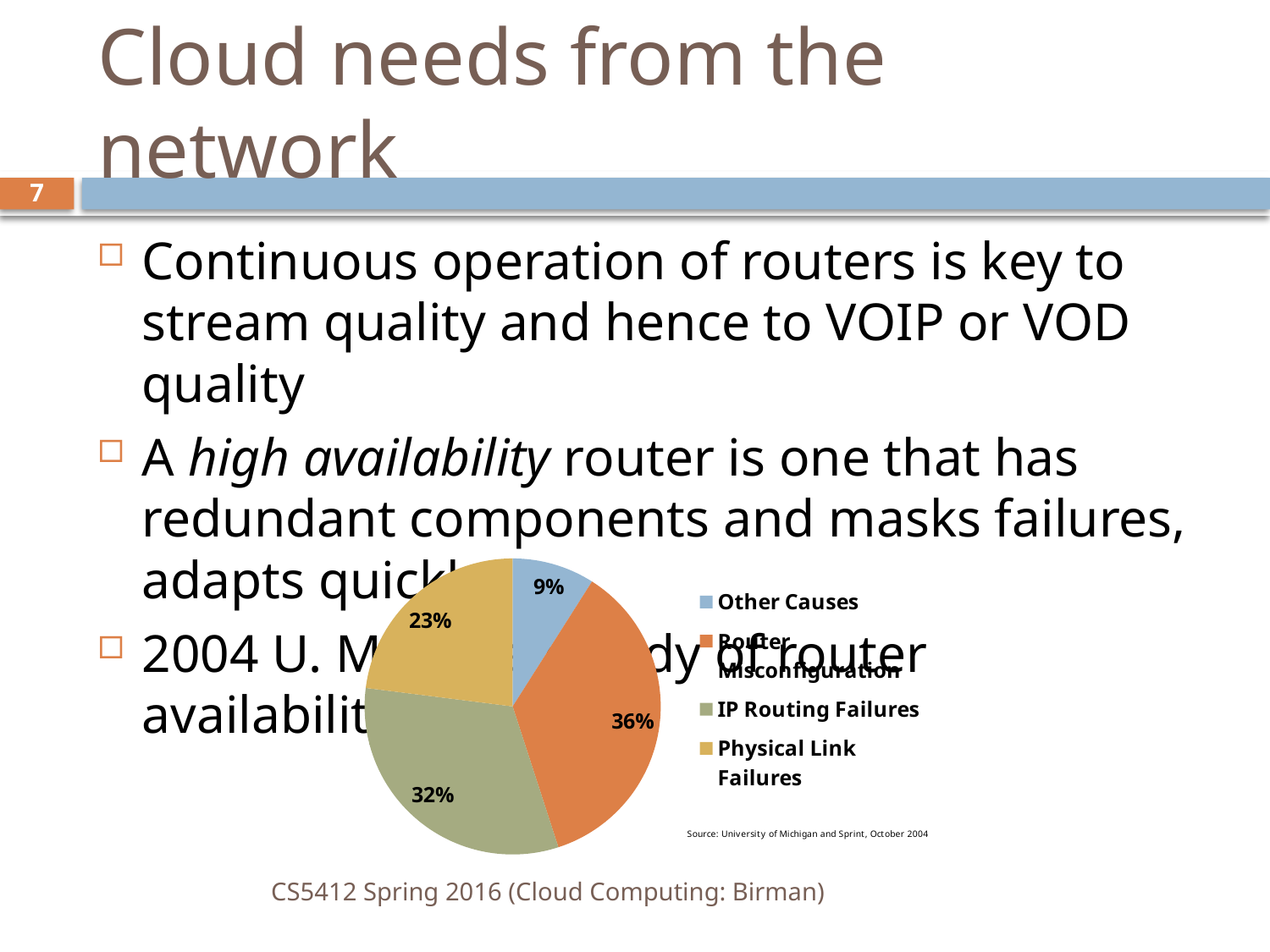
What percentage of the pie is attributed to Other Causes? 9% What percentage of the pie is attributed to Router Misconfiguration? 36% What colour is the slice for Physical Link Failures? yellow What is the difference in percentage points between Router Misconfiguration and Physical Link Failures? 13 Which category has the smallest share of the pie? Other Causes Which category has the largest share of the pie? Router Misconfiguration According to the source note under the chart, which organisations provided the data? University of Michigan and Sprint How many slices does the pie chart have? 4 What percentage of the pie is attributed to IP Routing Failures? 32% What type of chart is shown on the slide? pie chart Which is larger, the share for IP Routing Failures or the share for Physical Link Failures? IP Routing Failures What percentage of the pie is attributed to Physical Link Failures? 23%